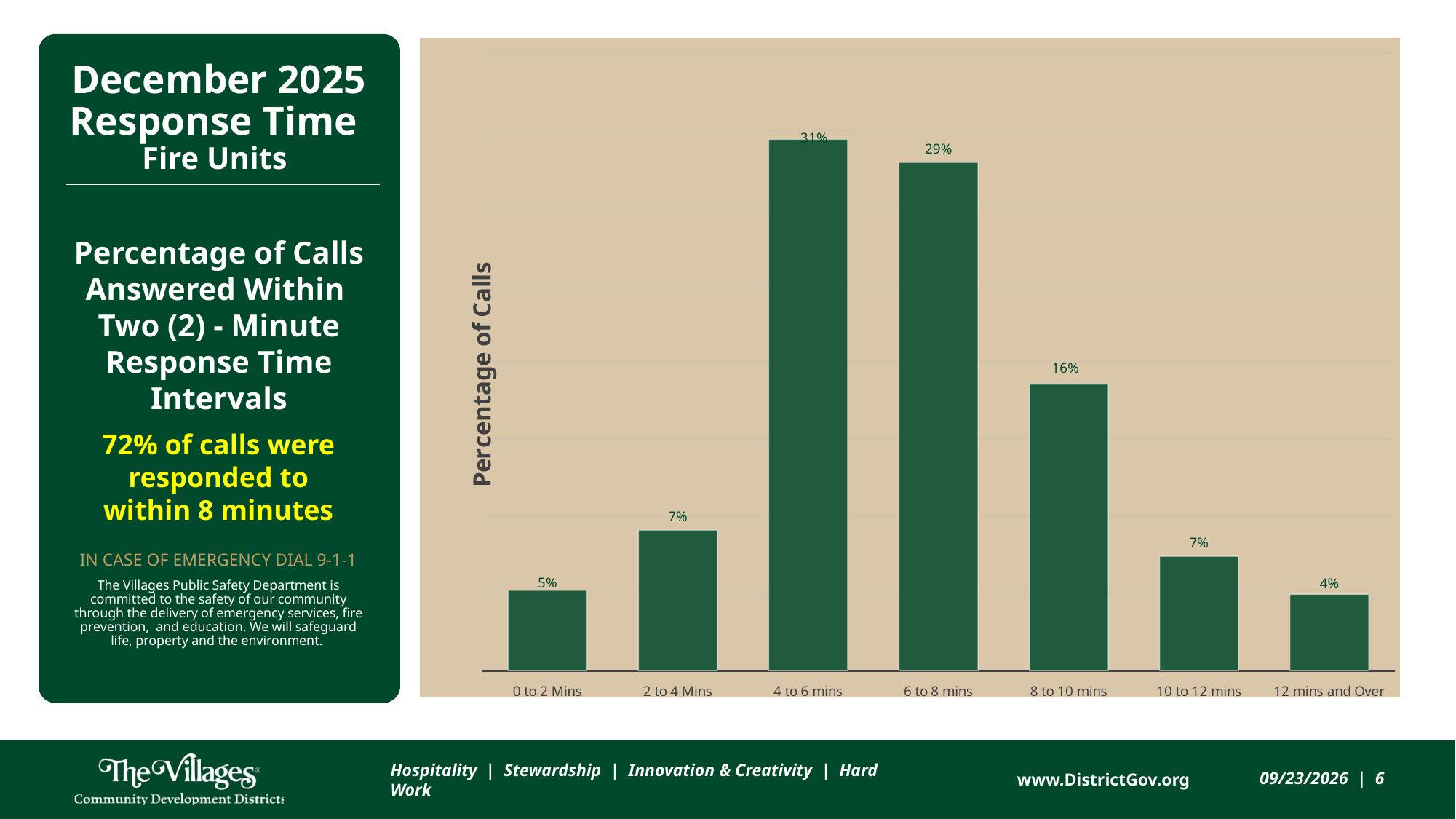
What percentage of calls fall in the 12 mins and Over category? 4% What is the value for the 0 to 2 Mins interval? 5% What percentage of calls were answered in the 4 to 6 mins interval? 31% What is the difference between the 4 to 6 mins and 6 to 8 mins values? 2% Which is larger, the value for 6 to 8 mins or the value for 8 to 10 mins? 6 to 8 mins Which response time interval has the highest percentage of calls? 4 to 6 mins What is the label on the vertical axis of the chart? Percentage of Calls How many response time intervals are shown on the x axis? 7 What type of chart is shown on the slide? Bar chart Which response time interval has the lowest percentage of calls? 12 mins and Over What is the difference between the 8 to 10 mins value and the 10 to 12 mins value? 9% What is the value shown for the 8 to 10 mins bar? 16%